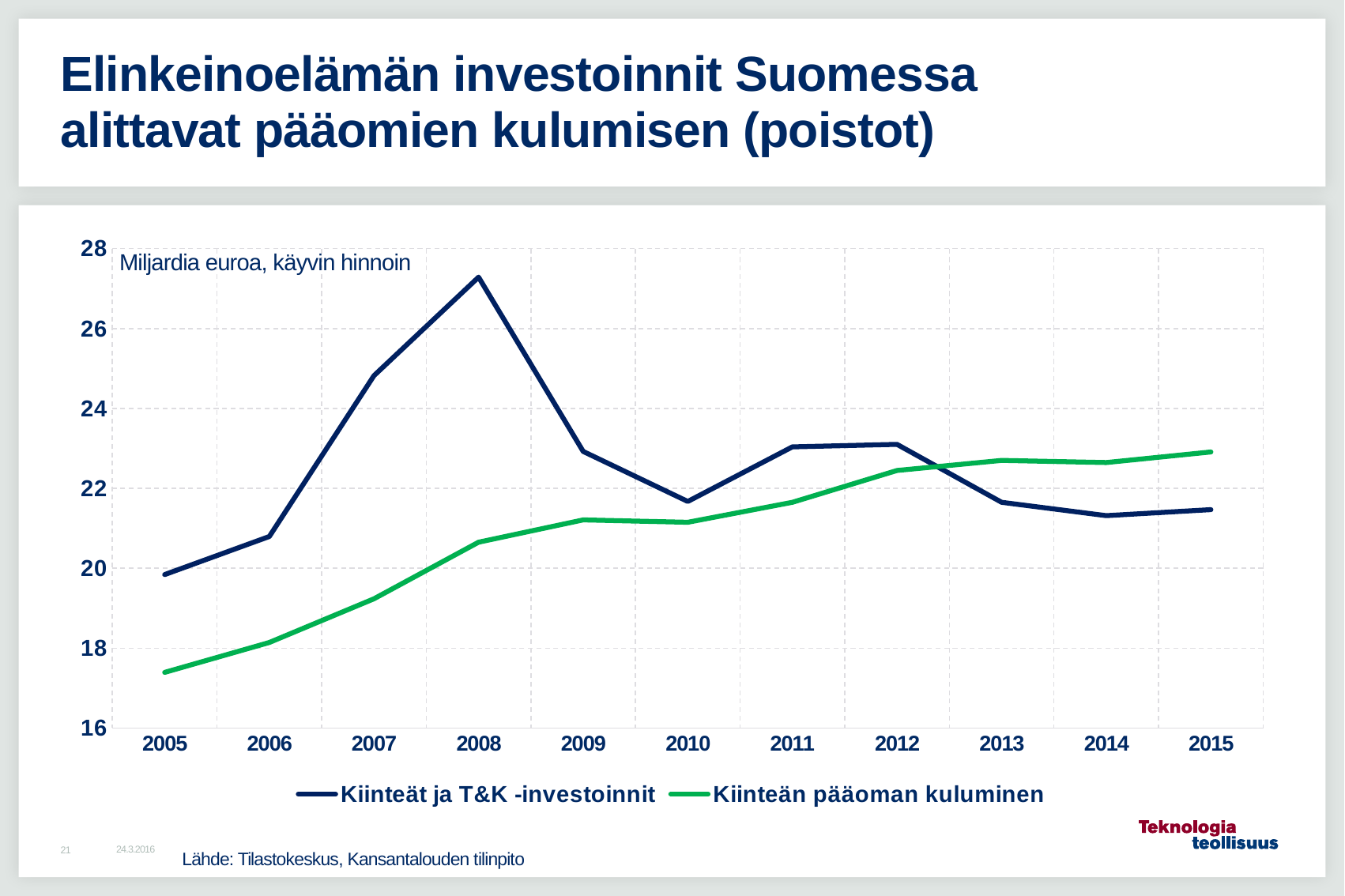
Does the Kiinteän pääoman kuluminen series generally rise or fall from 2005 to 2015? rise What kind of chart is shown on the slide? line chart How many years are plotted along the x axis? 11 Is the value for Kiinteän pääoman kuluminen in 2015 greater or less than 22? greater In 2015, which series has the higher value: Kiinteät ja T&K -investoinnit or Kiinteän pääoman kuluminen? Kiinteän pääoman kuluminen Is the value for Kiinteän pääoman kuluminen in 2005 greater or less than 18? less How many series does the legend list? 2 Is the value for Kiinteät ja T&K -investoinnit in 2007 greater or less than 24? greater What unit is stated in the chart's label at the top left of the plot area? Miljardia euroa, käyvin hinnoin In which year is the Kiinteän pääoman kuluminen series at its lowest? 2005 In which year does the Kiinteät ja T&K -investoinnit series reach its highest value? 2008